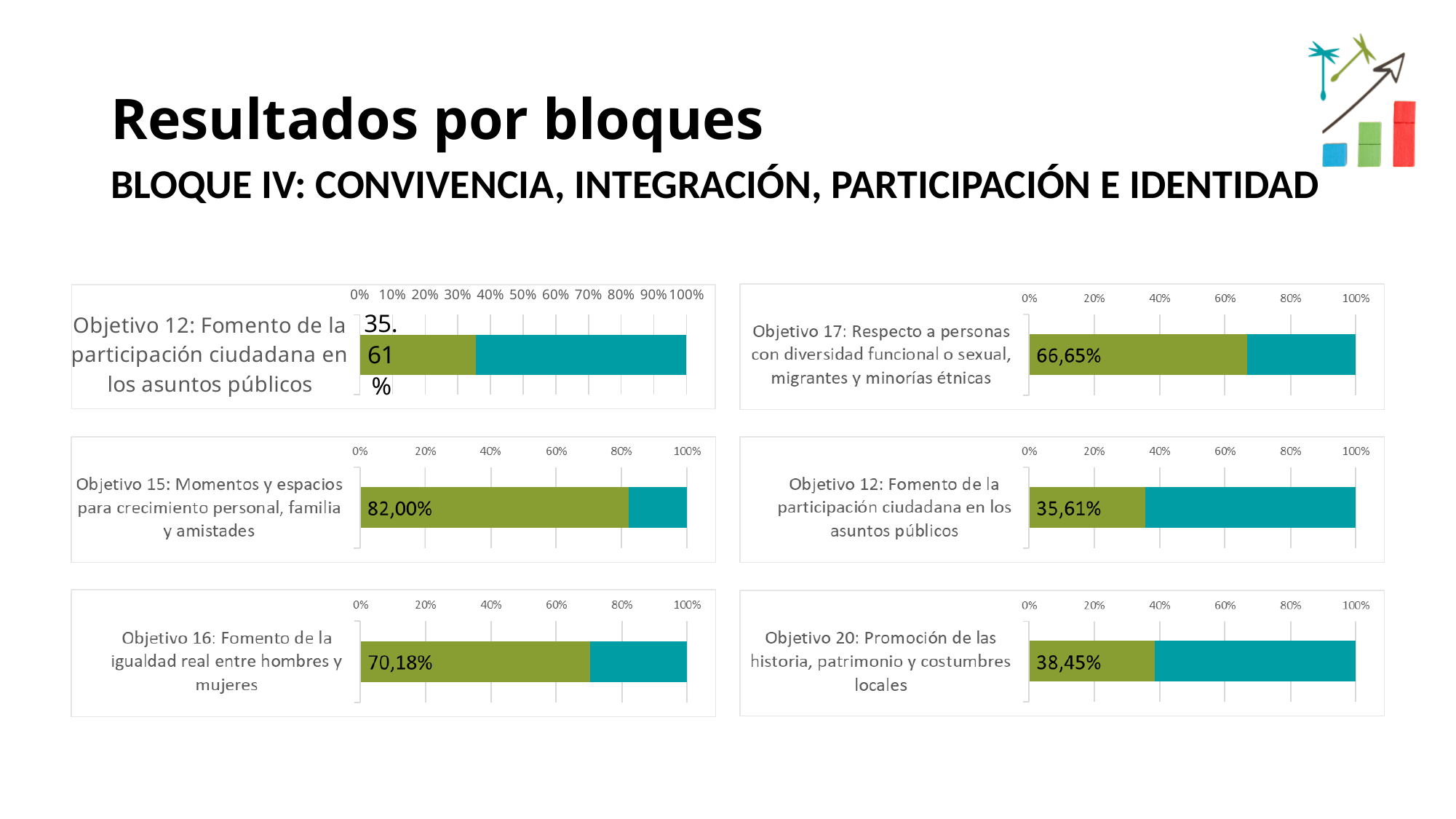
In the chart for Objetivo 16 (Fomento de la igualdad real entre hombres y mujeres), what value is printed on the green bar? 70,18% In the chart for Objetivo 16, is the green bar's value greater or less than 60%? greater What kind of chart is used for Objetivo 20 (Promoción de las historia, patrimonio y costumbres locales)? Bar chart Across the six charts on the slide, which objetivo has the lowest printed green-bar value? Objetivo 12 In the chart for Objetivo 15 (Momentos y espacios para crecimiento personal, familia y amistades), what value is printed on the green bar? 82,00% In the chart for Objetivo 20 (Promoción de las historia, patrimonio y costumbres locales), what value is printed on the green bar? 38,45% In the chart for Objetivo 17 (Respecto a personas con diversidad funcional o sexual, migrantes y minorías étnicas), what value is printed on the green bar? 66,65% In the middle-right chart for Objetivo 12 (Fomento de la participación ciudadana en los asuntos públicos), what value is printed on the green bar? 35,61% What is the difference between the printed value for Objetivo 15 and the printed value for Objetivo 16? 11,82% Across the six charts on the slide, which objetivo has the highest printed green-bar value? Objetivo 15 Which printed value is larger: Objetivo 17 or Objetivo 20? Objetivo 17 How many separate charts are shown on the slide? 6